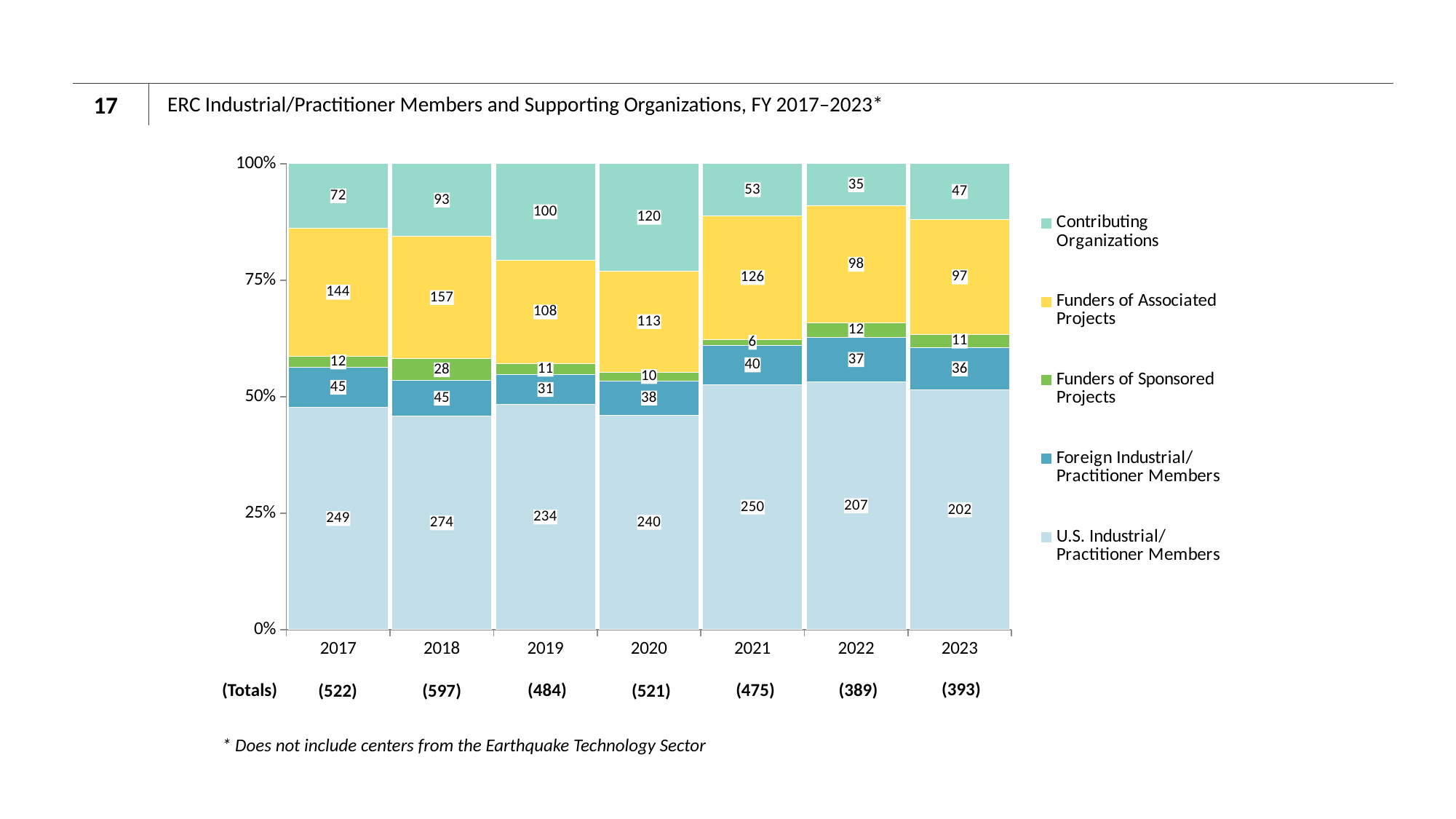
In which year is the value for Funders of Sponsored Projects lowest? 2021 What is the value for Contributing Organizations in 2020? 120 How many years are shown on the x axis? 7 What is the value for Funders of Associated Projects in 2021? 126 What is the difference between the Contributing Organizations values for 2020 and 2022? 85 Which is larger: Foreign Industrial/Practitioner Members in 2017 or in 2019? 2017 What is the value for U.S. Industrial/Practitioner Members in 2018? 274 What is the total shown for the 2019 bar? 484 In which year is the value for Funders of Associated Projects highest? 2018 What kind of chart is shown on the slide? 100% stacked bar chart What is the value for Funders of Sponsored Projects in 2022? 12 How many series does the legend list? 5